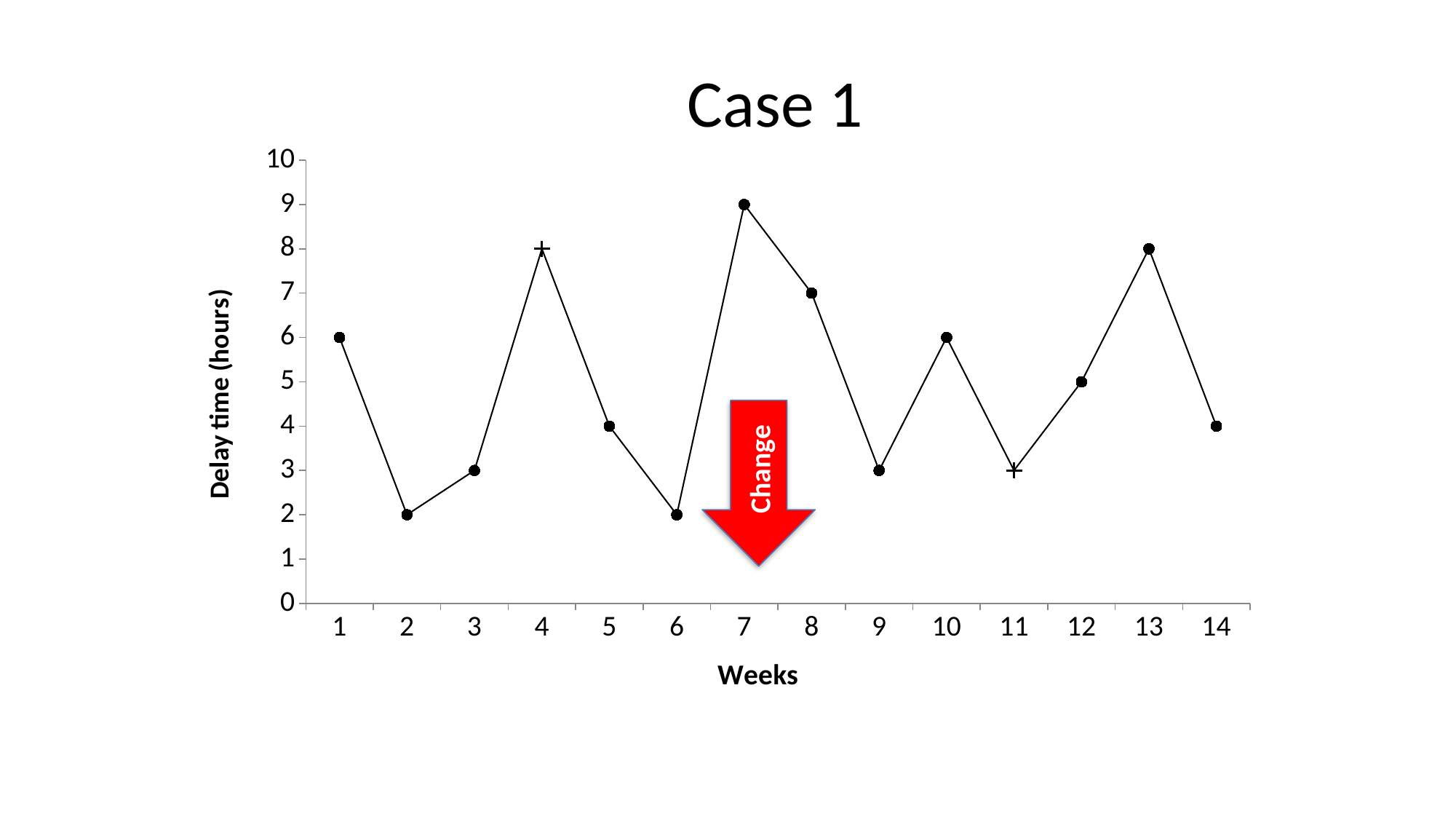
What is the label of the y axis? Delay time (hours) What is the delay time in week 7? 9 Is the delay time in week 8 greater or less than 5? greater What is the delay time in week 13? 8 Which week has the highest delay time? Week 7 How many weeks are plotted on the x axis? 14 Which is larger, the delay time in week 4 or in week 5? Week 4 What kind of chart is shown on the slide? Line chart What is the delay time in week 2? 2 Does the delay time rise or fall from week 1 to week 2? Fall What is the difference in delay time between week 7 and week 6? 7 What is the title of the chart? Case 1